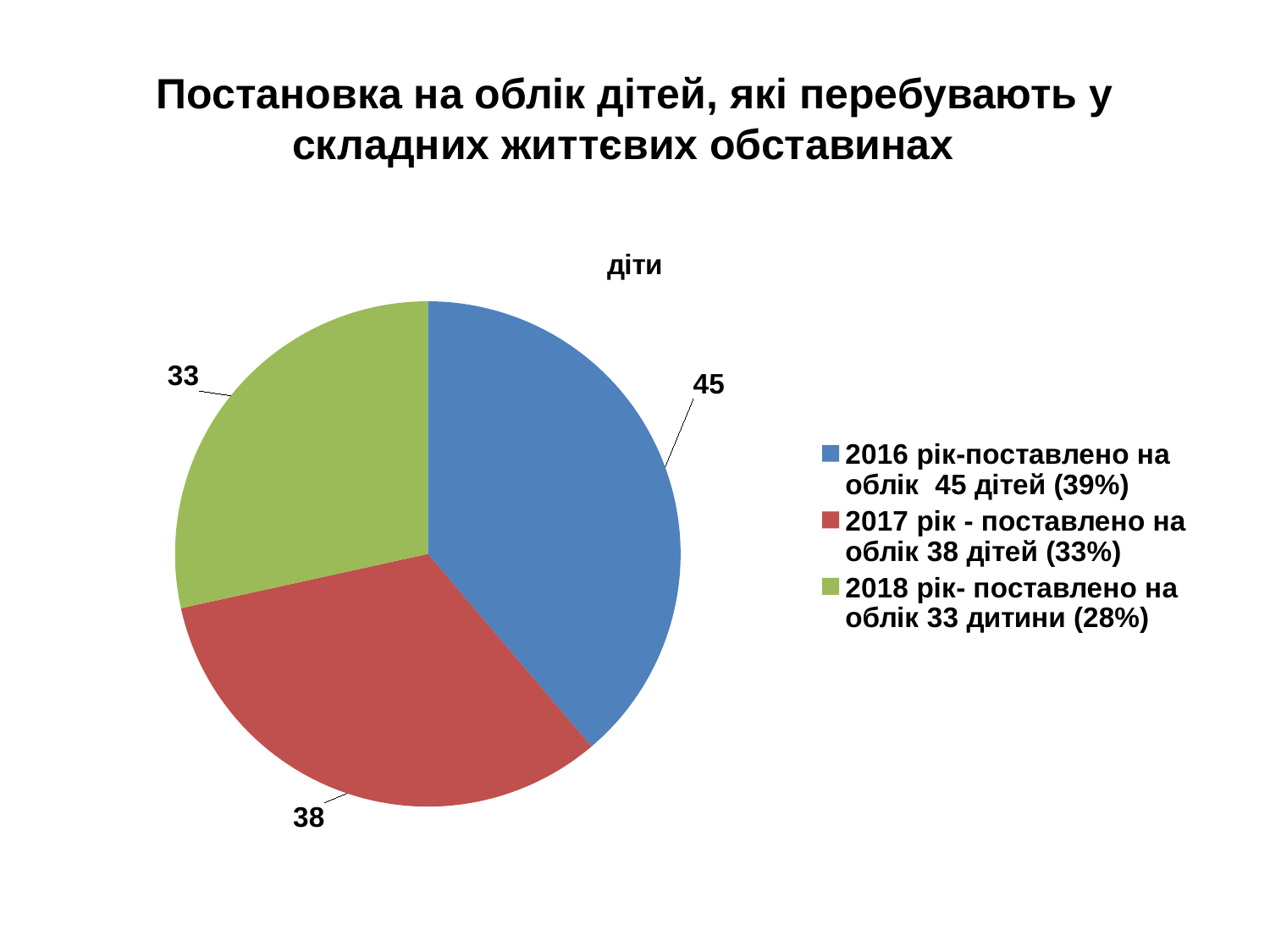
What is the difference between the values for 2016 and 2018? 12 What is the value of the slice for 2016? 45 What share of the pie does the 2016 slice represent, as shown in the legend? 39% Which year has the largest slice? 2016 Which is larger, the value for 2017 or the value for 2018? 2017 What kind of chart is shown on the slide? pie chart What is the value of the slice for 2018? 33 What is the title of the chart above the pie? діти How many slices does the pie chart have? 3 Which year has the smallest slice? 2018 What is the difference between the values for 2017 and 2018? 5 What is the value of the slice for 2017? 38